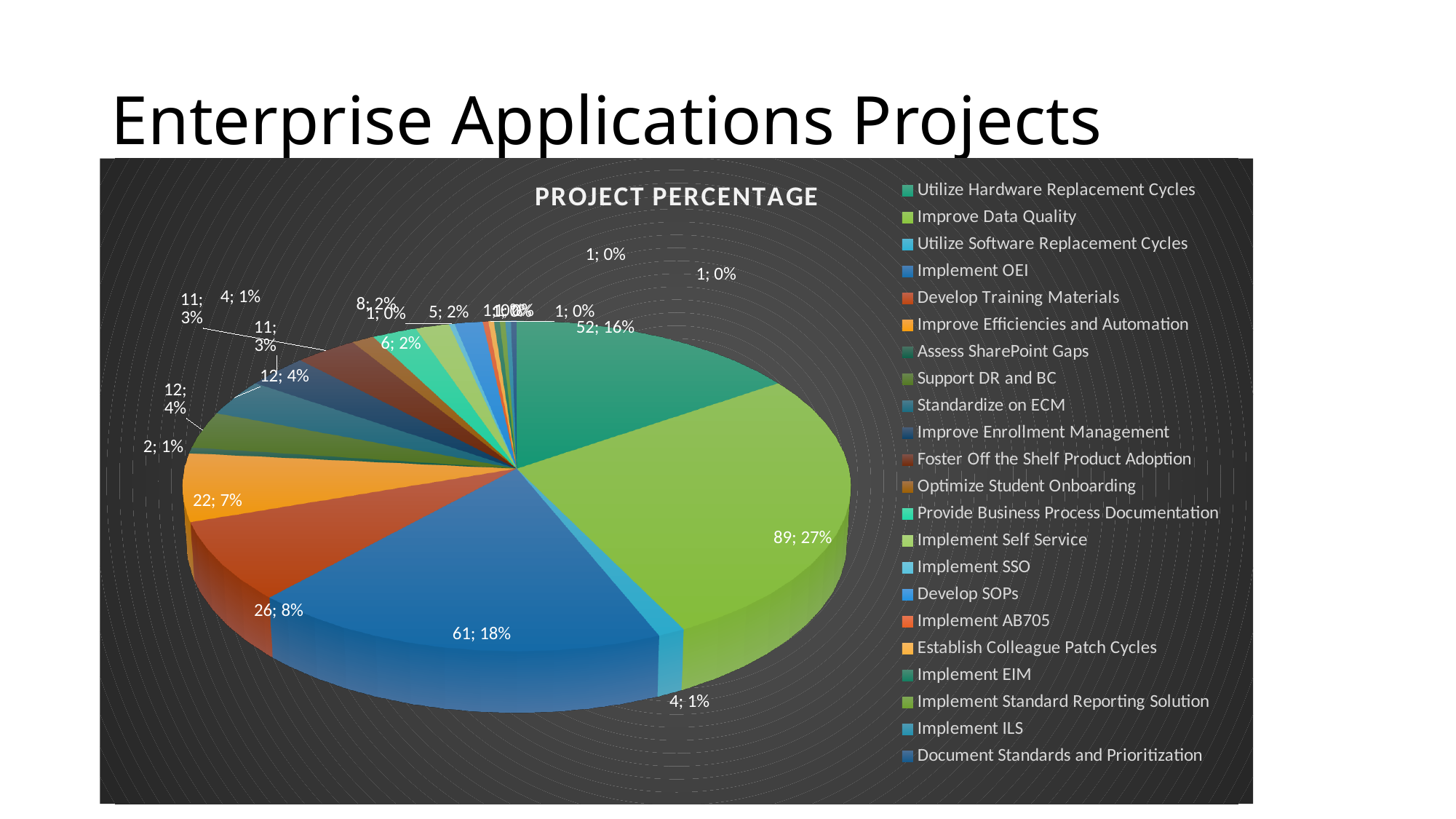
What value is shown for Utilize Hardware Replacement Cycles? 52; 16% Which is larger, Utilize Hardware Replacement Cycles or Develop Training Materials? Utilize Hardware Replacement Cycles Which category has the largest slice of the pie? Improve Data Quality What value is shown for Develop Training Materials? 26; 8% What is the difference in count between Improve Data Quality and Implement OEI? 28 What value is shown for Improve Efficiencies and Automation? 22; 7% What value is shown for Implement OEI? 61; 18% What type of chart is shown on the slide? pie chart How many categories does the legend list? 22 What share of the pie does Implement OEI represent? 18% What value is shown for Improve Data Quality? 89; 27% What is the title of the chart? PROJECT PERCENTAGE